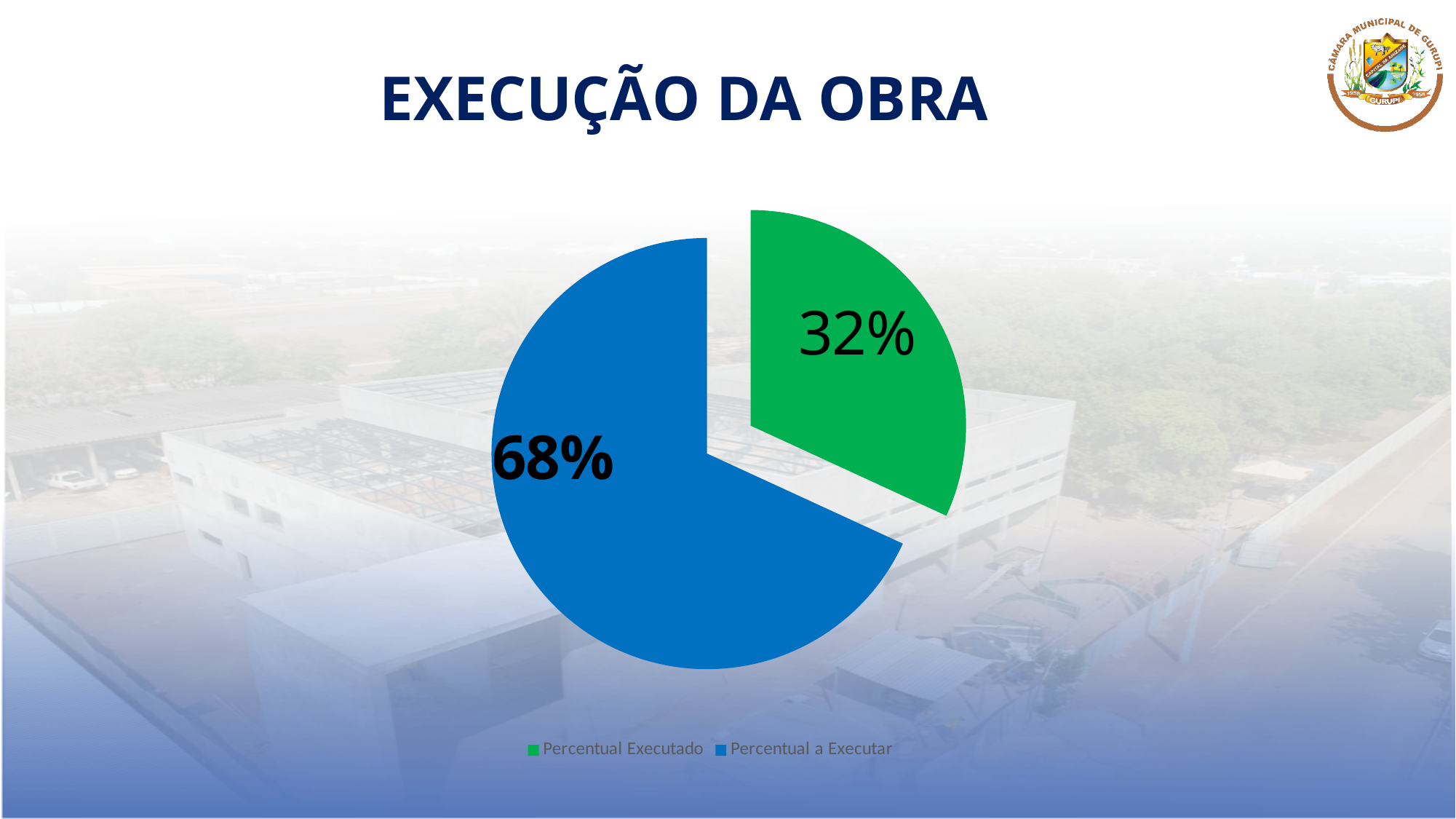
Which is larger, Percentual Executado or Percentual a Executar? Percentual a Executar What kind of chart is shown on the slide? pie chart How many slices does the pie chart have? 2 Which slice is the smallest? Percentual Executado What is the difference between Percentual a Executar and Percentual Executado? 36% Which slice is the largest? Percentual a Executar What share of the pie does Percentual Executado represent? 32% What is the value for Percentual a Executar? 68% What is the title of the slide containing the chart? EXECUÇÃO DA OBRA What colour is the Percentual Executado slice? green What is the value for Percentual Executado? 32%